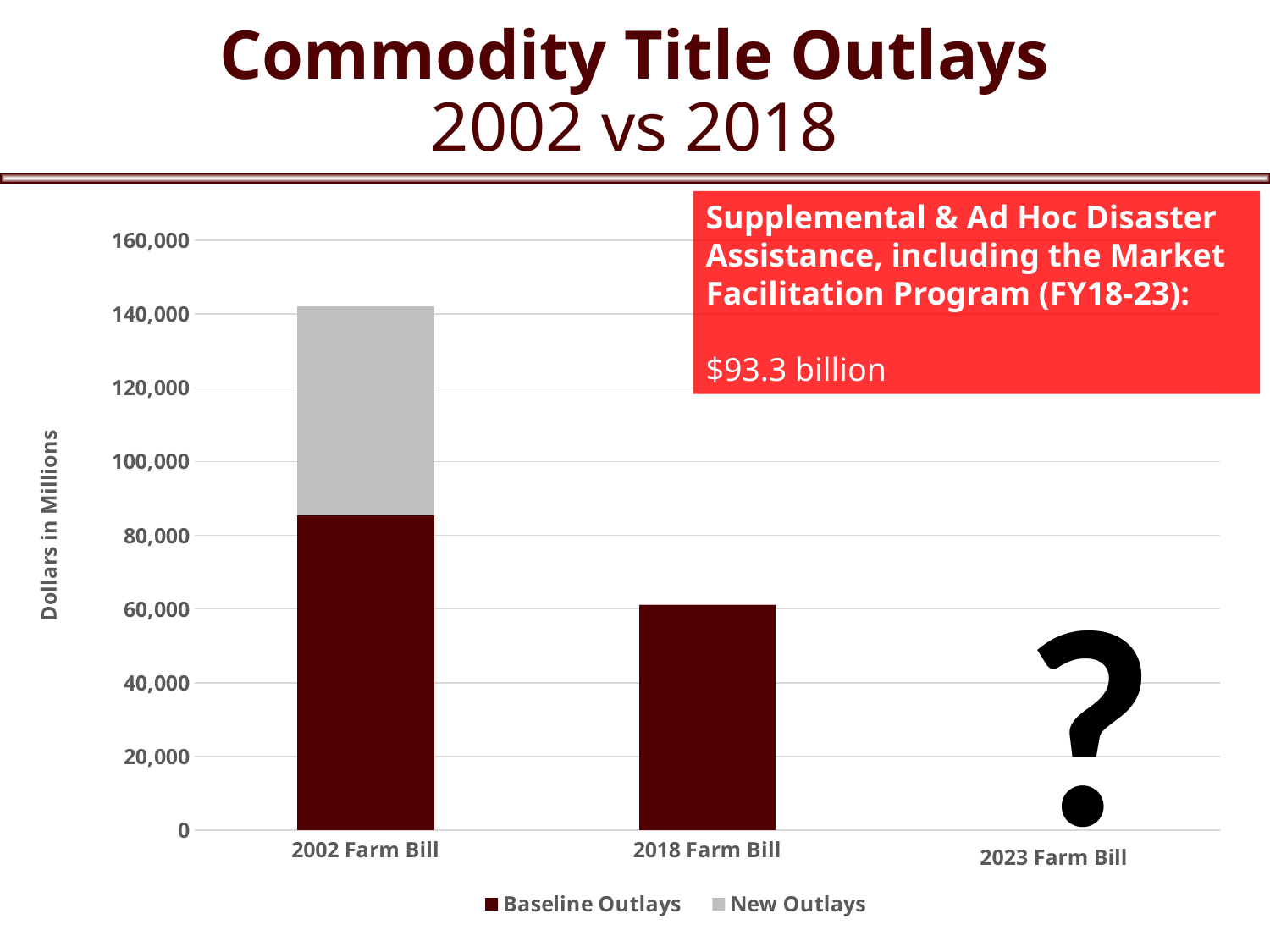
Which farm bill shows a New Outlays segment? 2002 Farm Bill Which category has no bar plotted and is marked with a question mark? 2023 Farm Bill Is the Baseline Outlays value for the 2002 Farm Bill greater or less than 80,000? greater Is the total value for the 2002 Farm Bill greater or less than 140,000? greater Is the Baseline Outlays value for the 2018 Farm Bill greater or less than 80,000? less Which farm bill has the taller total bar, 2002 or 2018? 2002 Farm Bill What kind of chart is shown on the slide? Stacked bar chart How many categories are shown on the x axis? 3 Do the Baseline Outlays values rise or fall from the 2002 Farm Bill to the 2018 Farm Bill? fall How many series does the legend list? 2 What is the label on the y axis? Dollars in Millions